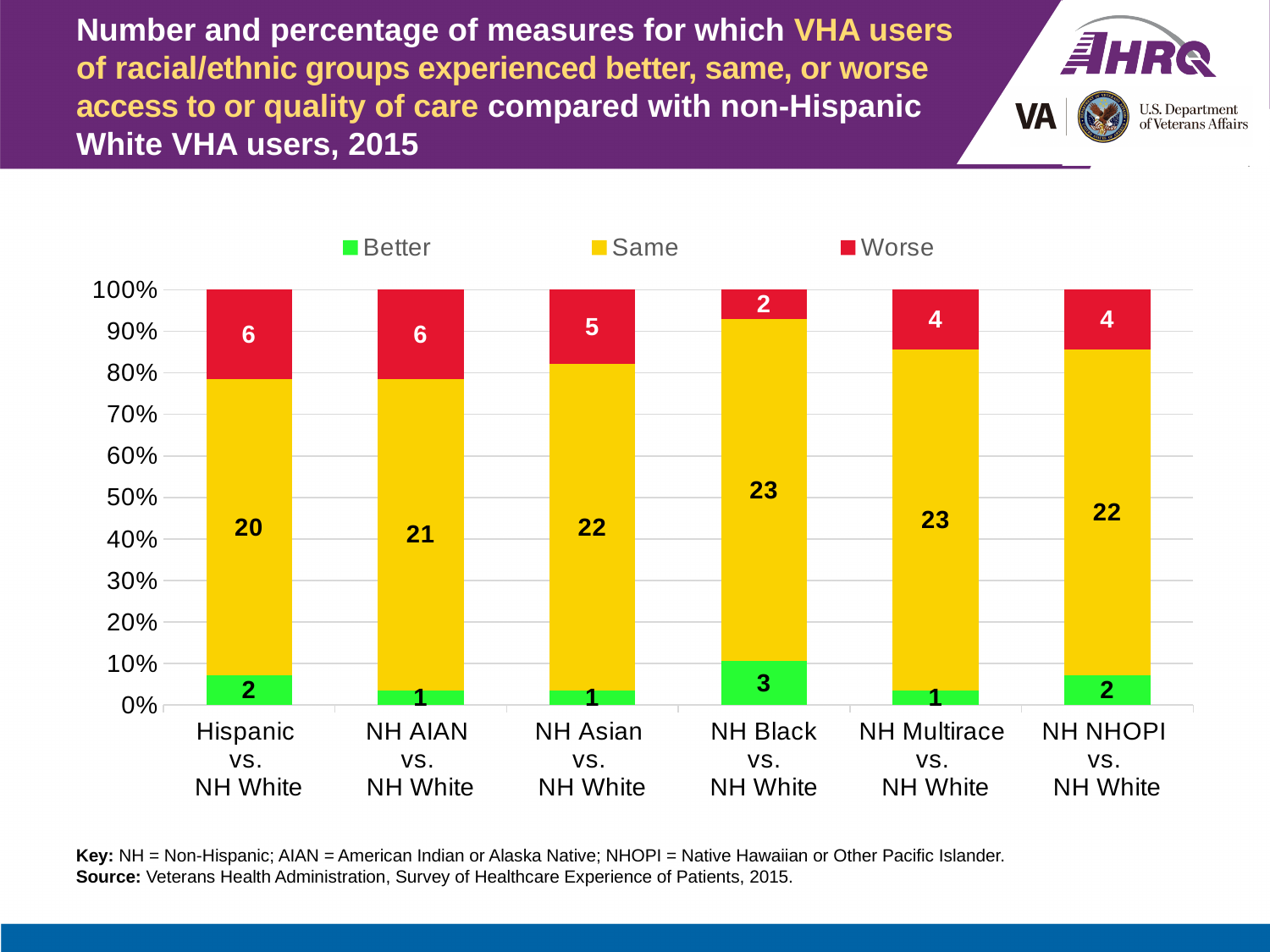
Which colour represents the 'Worse' series in the chart? Red What is the difference between the number of 'Worse' measures for NH AIAN vs. NH White and NH Black vs. NH White? 4 How many series does the legend list? 3 How many comparison groups are shown on the x axis? 6 Which comparison group has the lowest number of 'Worse' measures? NH Black vs. NH White How many measures were 'Same' for NH Black vs. NH White? 23 Which has more 'Same' measures: Hispanic vs. NH White or NH Asian vs. NH White? NH Asian vs. NH White What is the total number of measures in the bar for Hispanic vs. NH White? 28 What kind of chart is shown on the slide? Stacked bar chart How many measures were 'Better' for NH NHOPI vs. NH White? 2 Which comparison group has the highest number of 'Better' measures? NH Black vs. NH White How many measures were 'Worse' for Hispanic vs. NH White? 6